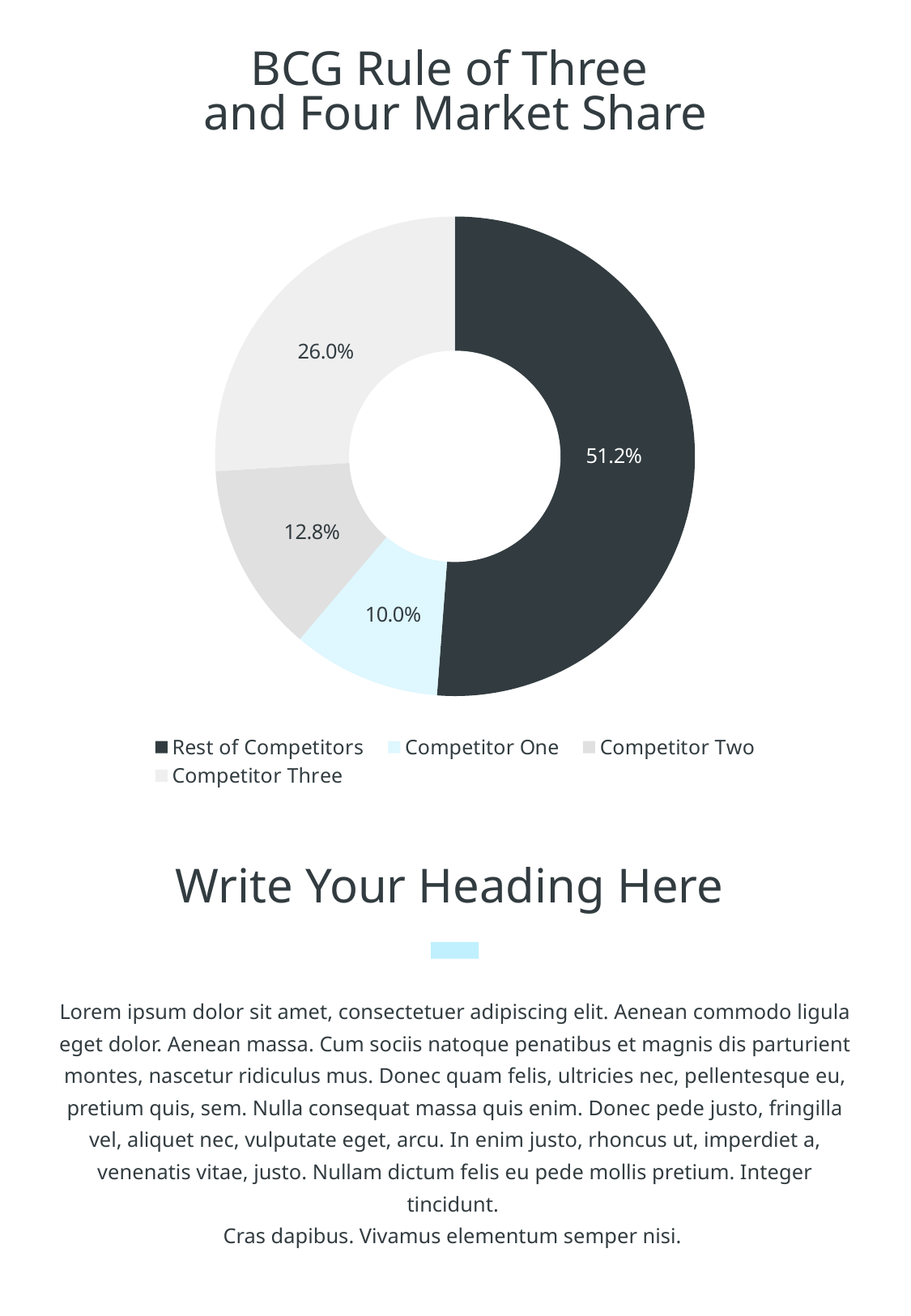
Which category has the largest slice of the chart? Rest of Competitors How many slices does the chart have? 4 Which legend entry is shown in light blue? Competitor One What is the difference between the shares of Competitor Three and Competitor Two? 13.2% What share of the market does Rest of Competitors hold? 51.2% What is the title of the chart? BCG Rule of Three and Four Market Share What is the value shown for Competitor Three? 26.0% What is the value shown for Competitor One? 10.0% Which is larger, the share of Competitor Two or the share of Competitor One? Competitor Two Which category has the smallest slice of the chart? Competitor One What kind of chart is shown on the slide? Doughnut (pie) chart What is the value shown for Competitor Two? 12.8%